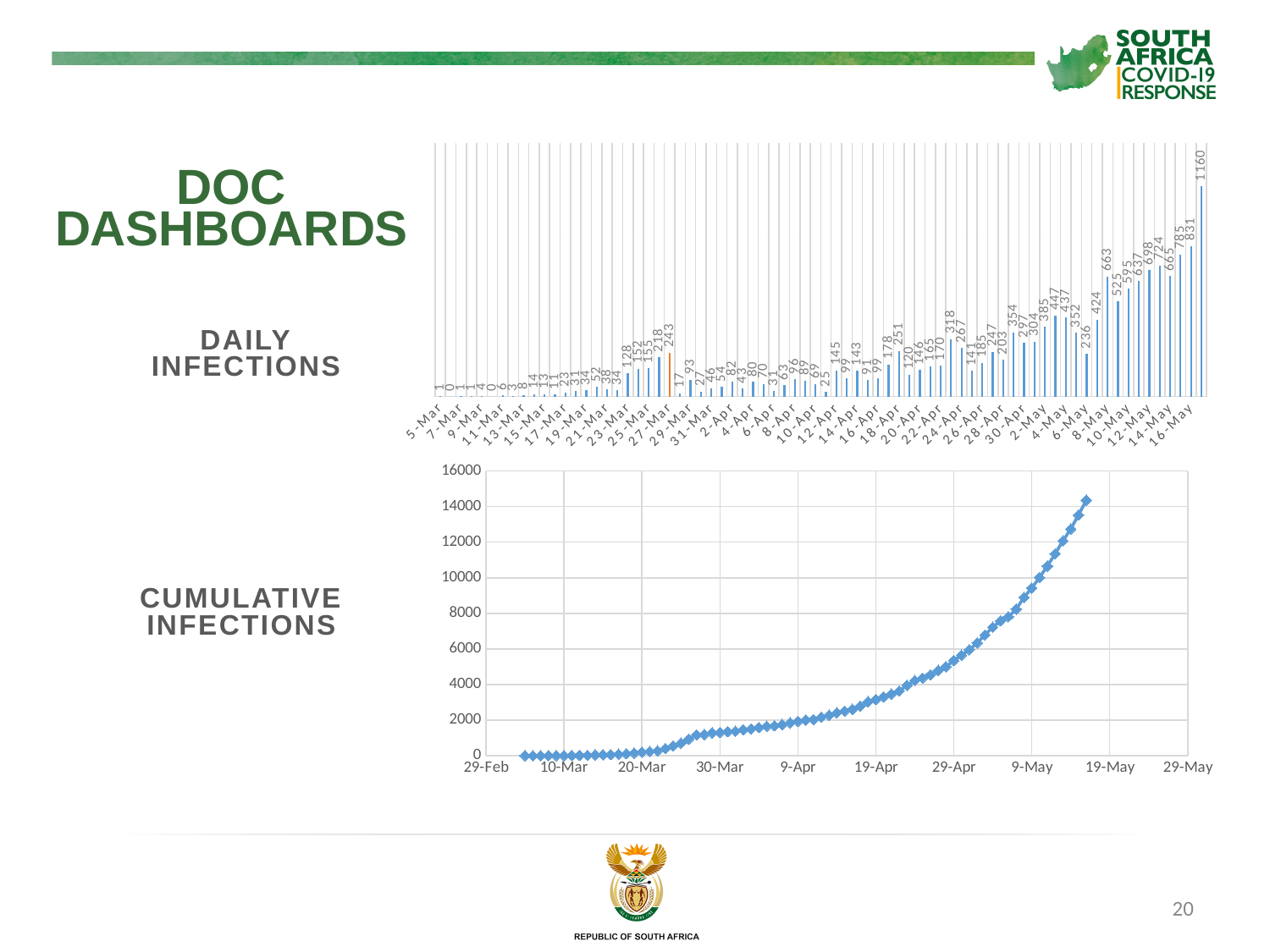
In the Cumulative Infections chart, is the last plotted value greater or less than 12000? greater In the Cumulative Infections chart, what is the maximum value shown on the y axis? 16000 In the Cumulative Infections chart, do the values rise or fall from 29-Feb to mid-May? rise In the Daily Infections chart, what is the highest daily value shown? 1160 In the Cumulative Infections chart, is the value at 19-Apr greater or less than 4000? less In the Cumulative Infections chart, is the value at 30-Mar greater or less than 2000? less What kind of chart is the Cumulative Infections chart at the bottom of the slide? line chart What kind of chart is the Daily Infections chart at the top of the slide? bar chart In the Daily Infections chart, is the highest bar at the start or the end of the date range? end In the Cumulative Infections chart, is the value at 9-May larger or smaller than the value at 9-Apr? larger